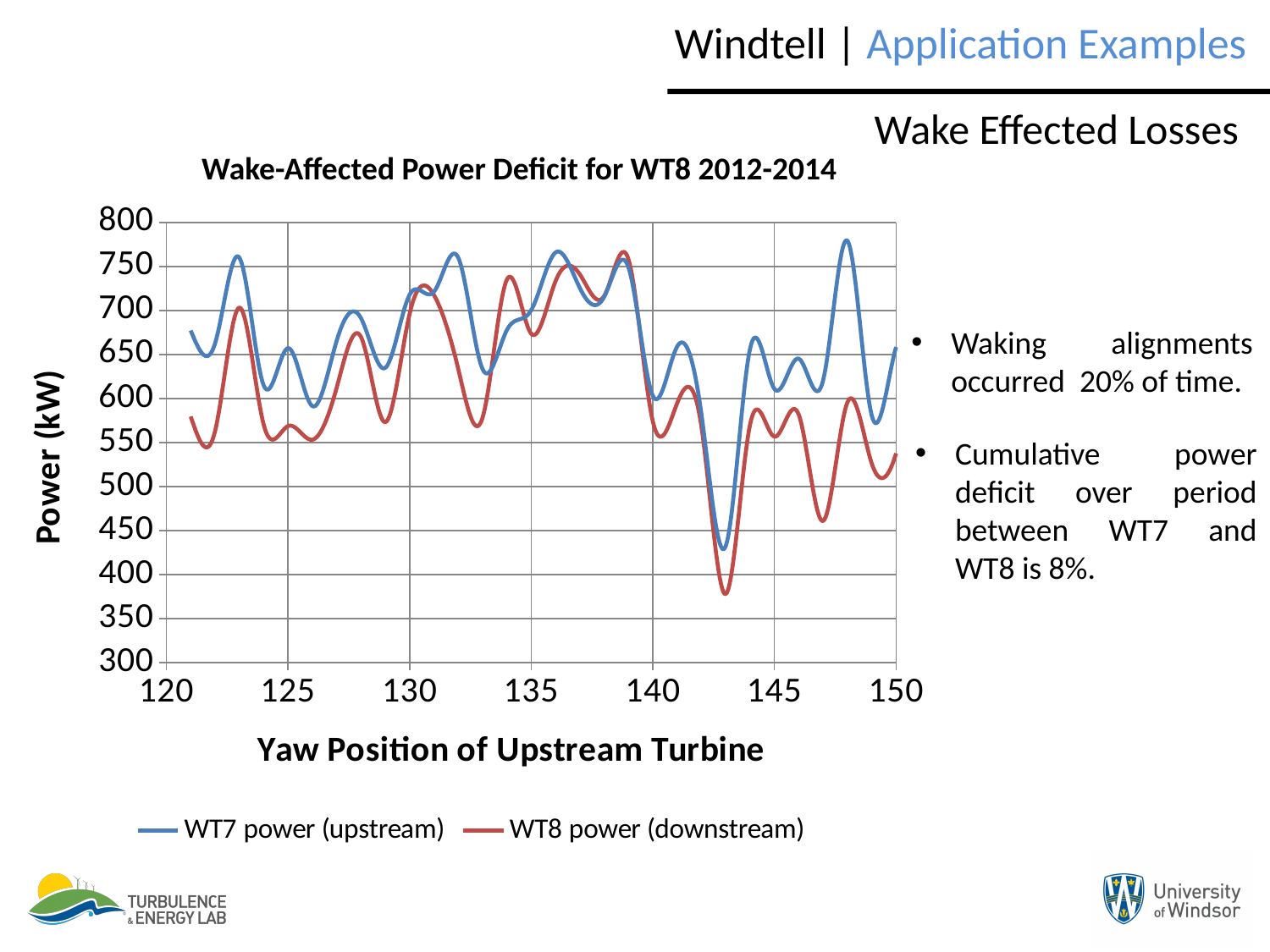
What is the title of the chart? Wake-Affected Power Deficit for WT8 2012-2014 At a yaw position of 143, which series has the lower power, WT7 power (upstream) or WT8 power (downstream)? WT8 power (downstream) Is the WT7 power (upstream) value at a yaw position of 123 greater or less than 700? greater How many series does the chart legend list? 2 What is the label of the y axis of the chart? Power (kW) Is the WT8 power (downstream) value at a yaw position of 143 greater or less than 400? less Is the WT7 power (upstream) value at a yaw position of 143 greater or less than 450? less At a yaw position of 148, which series has the higher power, WT7 power (upstream) or WT8 power (downstream)? WT7 power (upstream) What kind of chart is shown on the slide? line chart